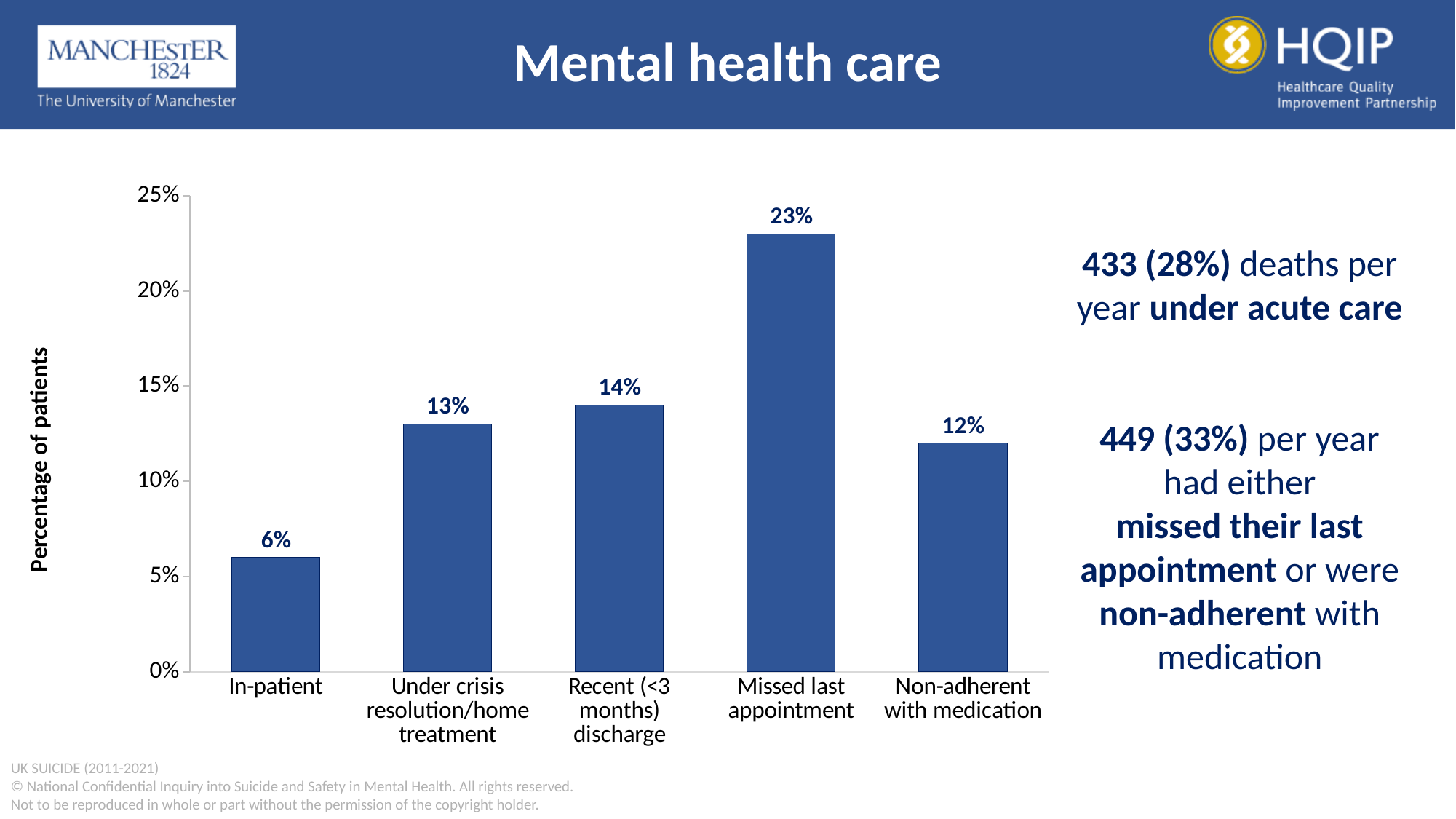
What is the label of the y axis of the chart? Percentage of patients What percentage of patients had missed their last appointment? 23% What percentage of patients were in-patients? 6% Is the value for 'Missed last appointment' greater or less than 20%? greater Which category has the lowest percentage of patients? In-patient What kind of chart is shown on the slide? Bar chart What percentage of patients were under crisis resolution/home treatment? 13% Which category has the highest percentage of patients? Missed last appointment How many categories are shown on the x axis of the chart? 5 What is the difference in percentage points between 'Missed last appointment' and 'In-patient'? 17 Which is larger: the percentage for 'Recent (<3 months) discharge' or for 'Non-adherent with medication'? Recent (<3 months) discharge What percentage of patients were non-adherent with medication? 12%